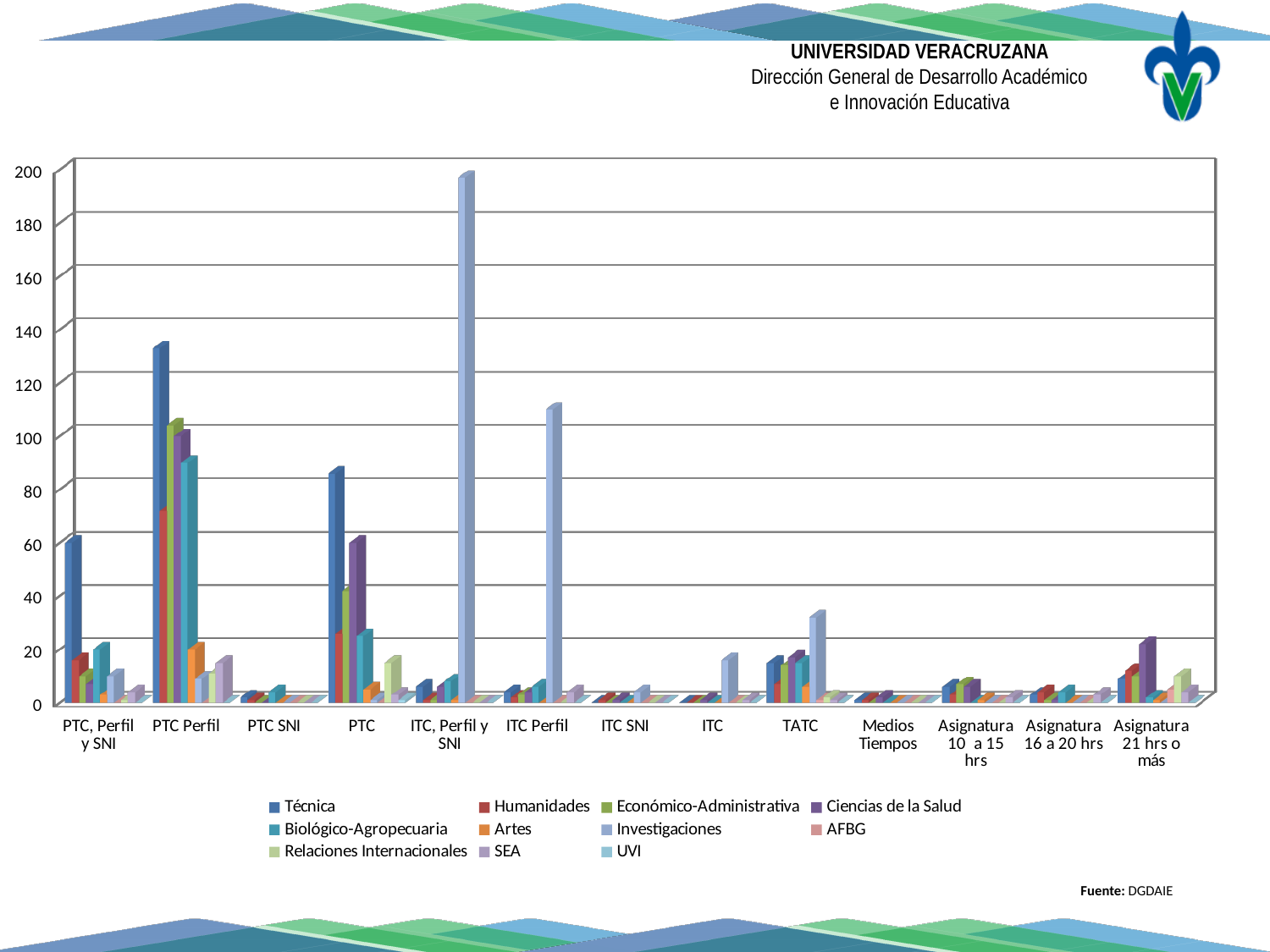
How many series does the legend list? 11 Is the value for Investigaciones in the ITC Perfil category greater or less than 100? greater How many categories are shown along the x axis? 13 Is the value for Investigaciones in the TATC category greater or less than 20? greater Which series has the highest value in the PTC Perfil category? Técnica What source is cited below the chart? DGDAIE Is the value for Técnica in the PTC Perfil category greater or less than 120? greater Which category contains the tallest bar in the chart? ITC, Perfil y SNI What kind of chart is shown on the slide? bar chart Which is larger: the Técnica value for PTC Perfil or the Técnica value for PTC? PTC Perfil